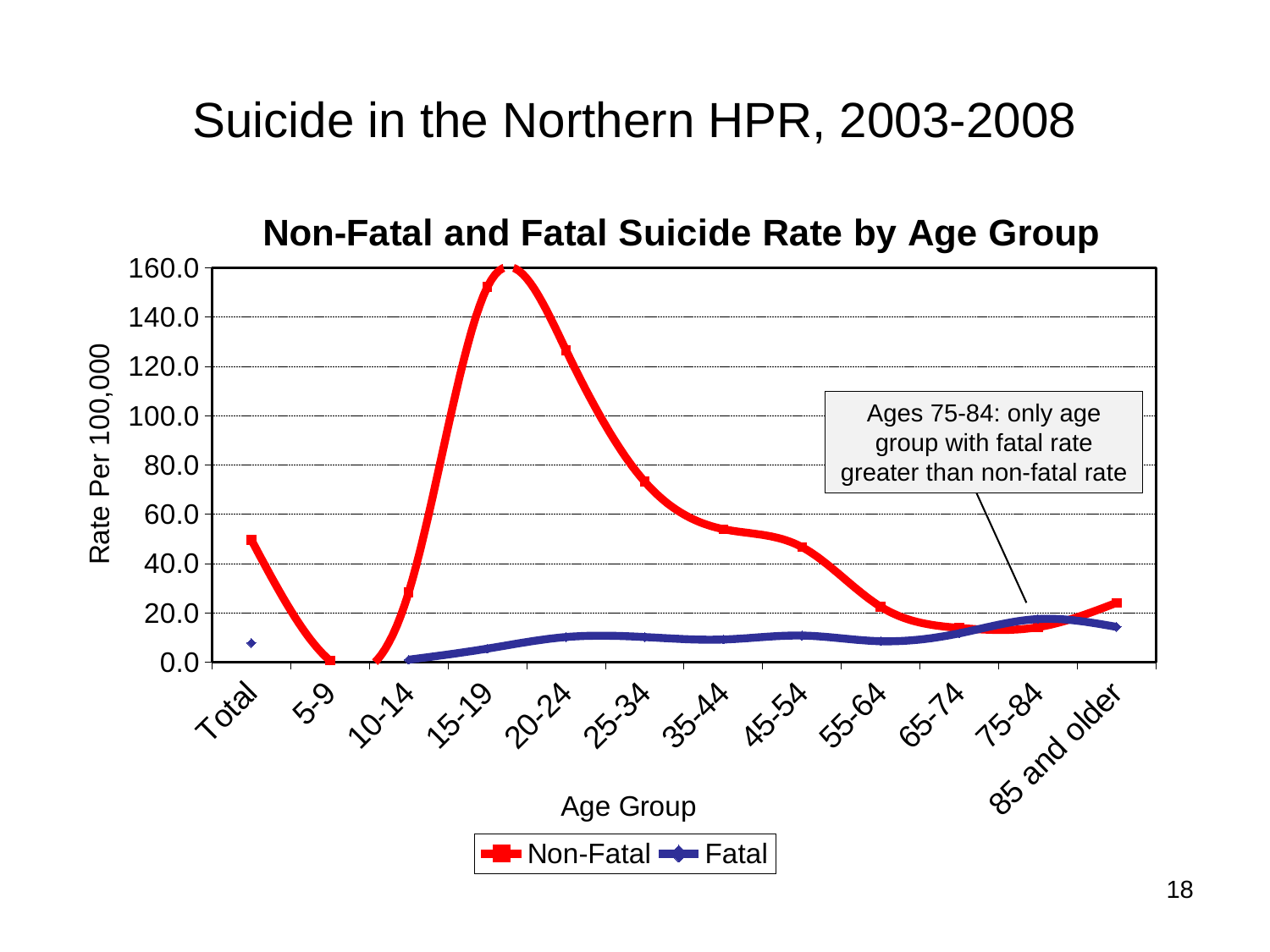
Is the Fatal value for 20-24 greater or less than 20? less How many series does the legend list? 2 Which age group has the highest Non-Fatal rate? 15-19 For the 75-84 age group, which series has the larger value, Non-Fatal or Fatal? Fatal Does the Non-Fatal rate rise or fall from 20-24 to 55-64? Fall Is the Non-Fatal value for 45-54 greater or less than 60? less Is the Non-Fatal value for Total greater or less than 40? greater How many age group categories are shown on the x axis? 12 What kind of chart is shown on the slide? Line chart For the 20-24 age group, which series has the larger value, Non-Fatal or Fatal? Non-Fatal What is the title of the y axis? Rate Per 100,000